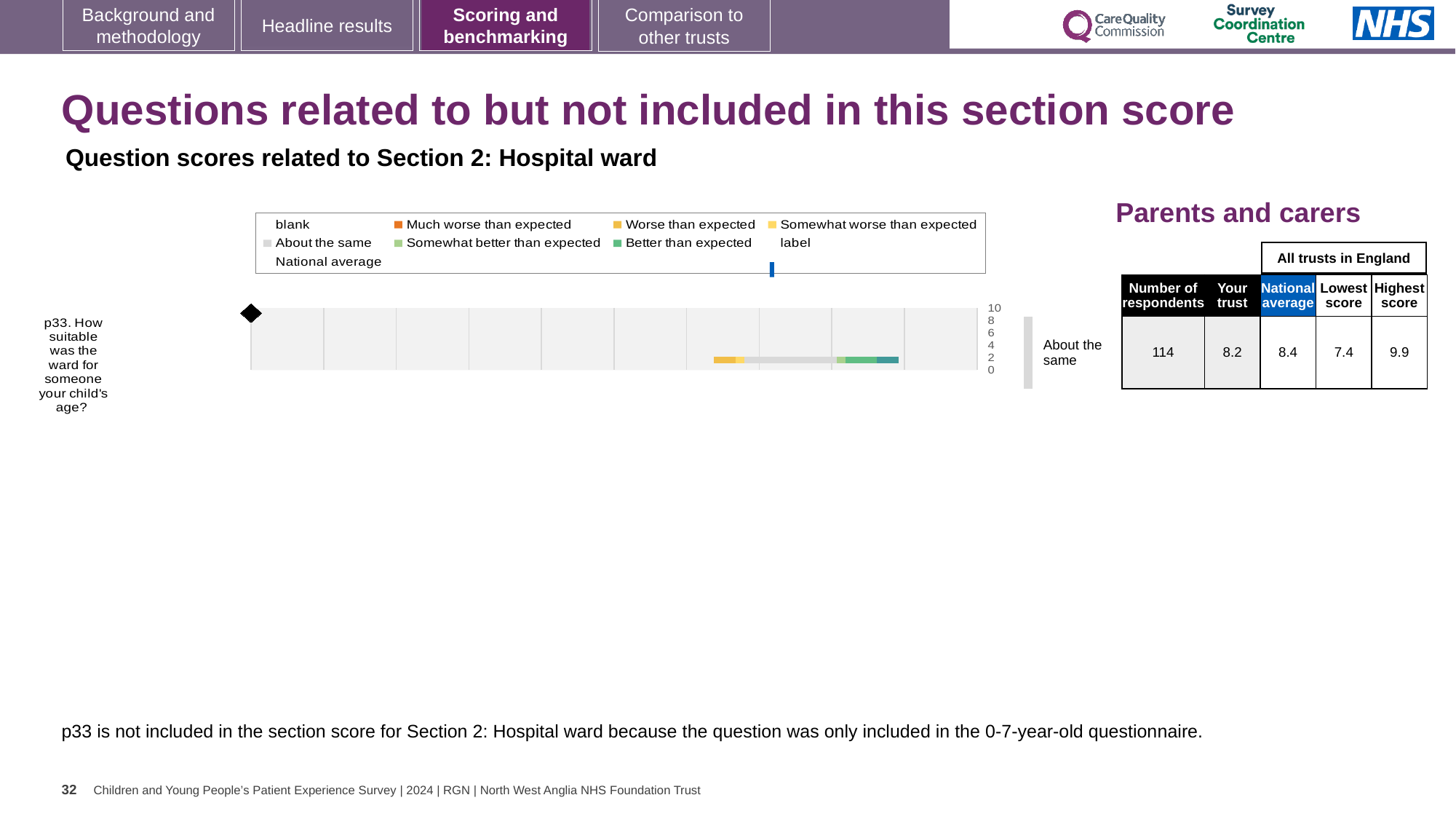
How many entries does the chart legend list? 9 What is the highest value shown on the chart's axis? 10 How many questions (categories) are plotted in the chart? 1 Which question is plotted in the chart? p33. How suitable was the ward for someone your child's age? In the table beside the chart, what is the number of respondents for p33? 114 What kind of chart is shown for question p33? bar chart In the table beside the chart, what is the 'Your trust' score for p33? 8.2 In the table beside the chart, what is the lowest score among all trusts in England for p33? 7.4 In the table beside the chart, what is the national average score for p33? 8.4 What benchmark category label is shown to the right of the p33 bar? About the same In the table beside the chart, what is the highest score among all trusts in England for p33? 9.9 In the table beside the chart, which is larger for p33: the 'Your trust' score or the national average? National average